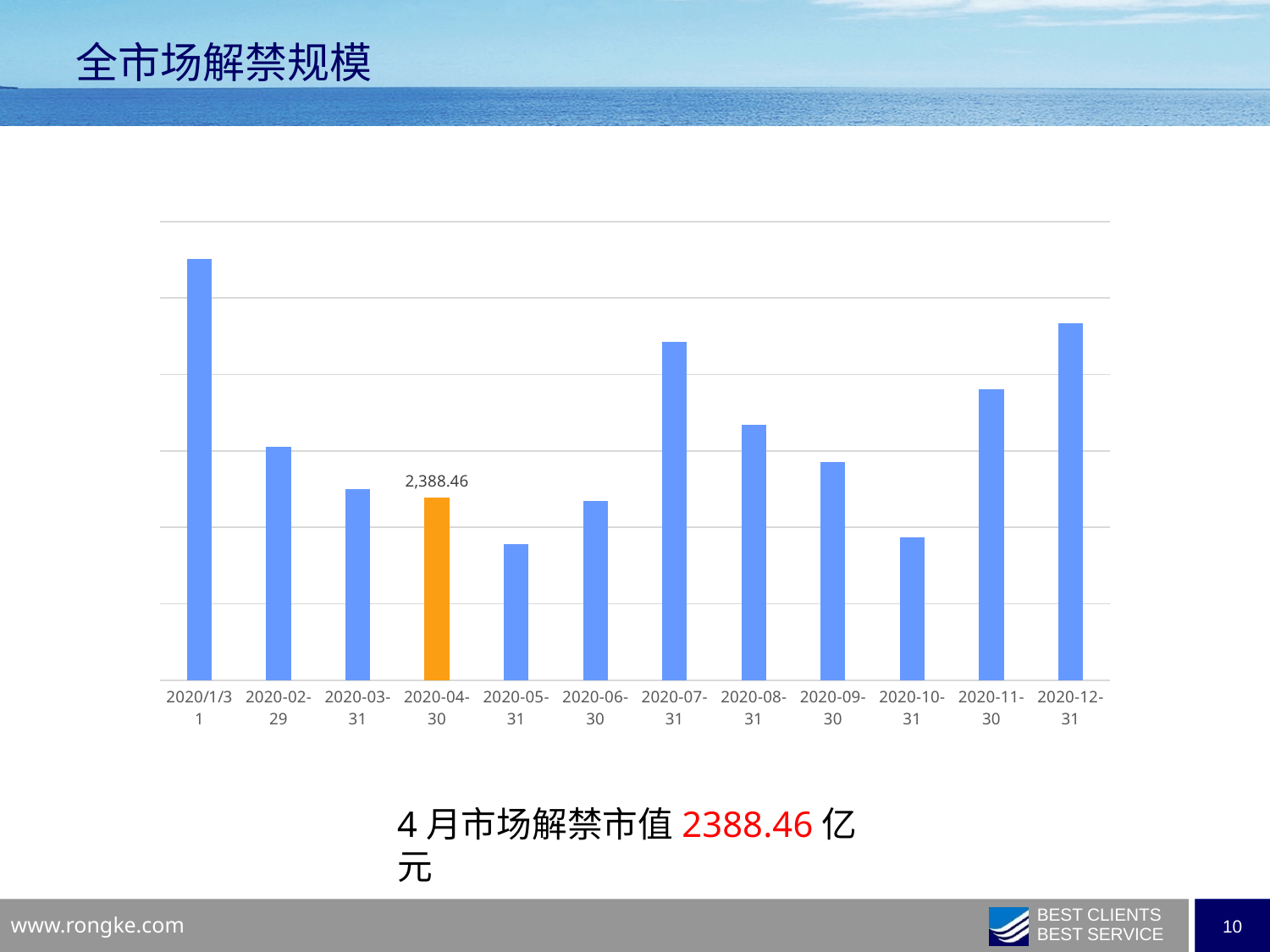
Which is larger, the value for 2020-07-31 or 2020-08-31? 2020-07-31 Do the values rise or fall from 2020-10-31 to 2020-12-31? rise Do the values rise or fall from 2020-07-31 to 2020-10-31? fall Which bar is highlighted in orange rather than blue? 2020-04-30 What is the title of the slide/chart? 全市场解禁规模 Which is larger, the value for 2020-02-29 or 2020-03-31? 2020-02-29 What kind of chart is shown on the slide? bar chart Which is larger, the value for 2020-06-30 or 2020-04-30? 2020-04-30 What is the value shown for 2020-04-30? 2,388.46 Which month has the highest value in the chart? 2020/1/31 How many bars (months) are plotted in the chart? 12